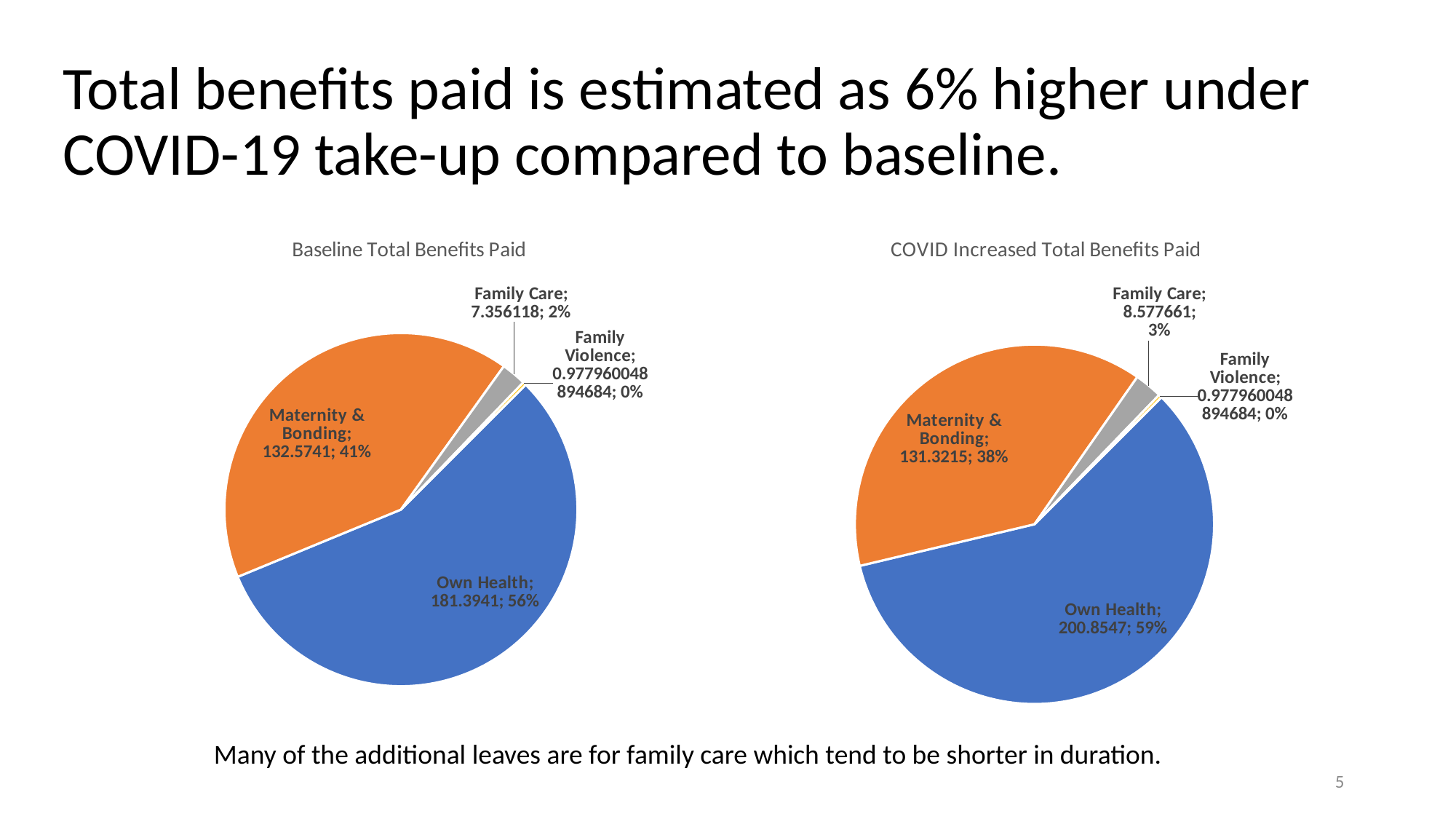
How many categories are shown in the Baseline Total Benefits Paid chart? 4 Is the Own Health value larger in the Baseline Total Benefits Paid chart or in the COVID Increased Total Benefits Paid chart? COVID Increased Total Benefits Paid What colour is the Maternity & Bonding slice in the Baseline Total Benefits Paid chart? Orange In the COVID Increased Total Benefits Paid chart, which category has the smallest slice? Family Violence In the Baseline Total Benefits Paid chart, what value is shown for Own Health? 181.3941 In the COVID Increased Total Benefits Paid chart, what value is shown for Family Care? 8.577661 What type of chart is the COVID Increased Total Benefits Paid chart? Pie chart In the Baseline Total Benefits Paid chart, what share of the pie does Maternity & Bonding represent? 41% In the Baseline Total Benefits Paid chart, which category has the largest slice? Own Health In the COVID Increased Total Benefits Paid chart, what share of the pie does Own Health represent? 59% In the Baseline Total Benefits Paid chart, what is the difference between the Own Health value and the Maternity & Bonding value? 48.82 In the COVID Increased Total Benefits Paid chart, what value is shown for Maternity & Bonding? 131.3215